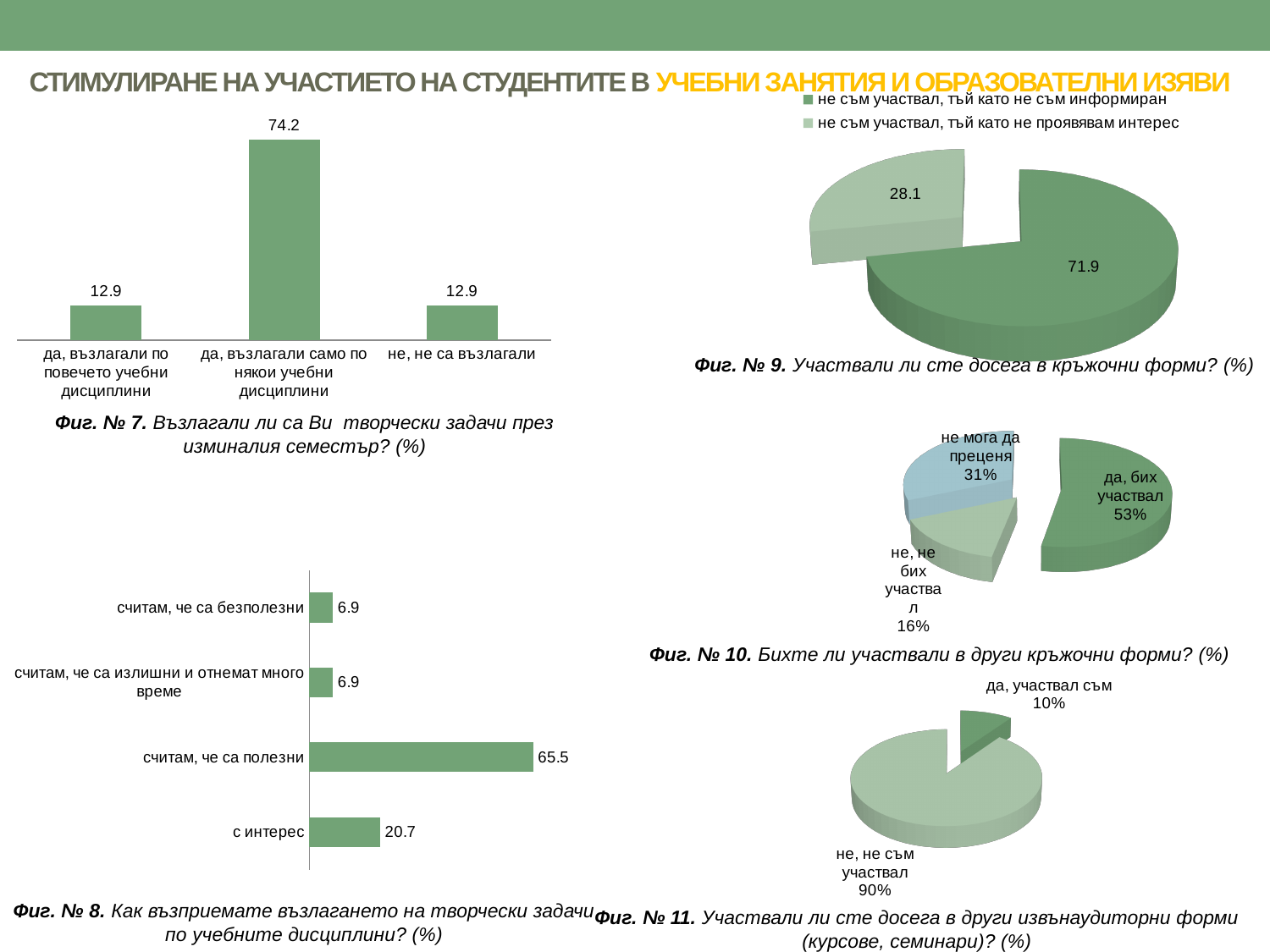
In the chart for Фиг. № 8, what is the difference between "считам, че са полезни" and "с интерес"? 44.8 In the chart for Фиг. № 8, how many categories are shown? 4 In the pie chart for Фиг. № 11, what share is "да, участвал съм"? 10% In the chart for Фиг. № 7, what is the value for "да, възлагали само по някои учебни дисциплини"? 74.2 In the chart for Фиг. № 7, which category has the highest value? да, възлагали само по някои учебни дисциплини In the pie chart for Фиг. № 10, what share is "не, не бих участвал"? 16% In the pie chart for Фиг. № 9, what is the value for "не съм участвал, тъй като не съм информиран"? 71.9 What kind of chart is Фиг. № 8? bar chart In the chart for Фиг. № 8, what is the value for "считам, че са полезни"? 65.5 How many entries does the legend of the Фиг. № 9 pie chart list? 2 In the pie chart for Фиг. № 10, which slice is the largest? да, бих участвал In the chart for Фиг. № 7, how many categories are shown? 3